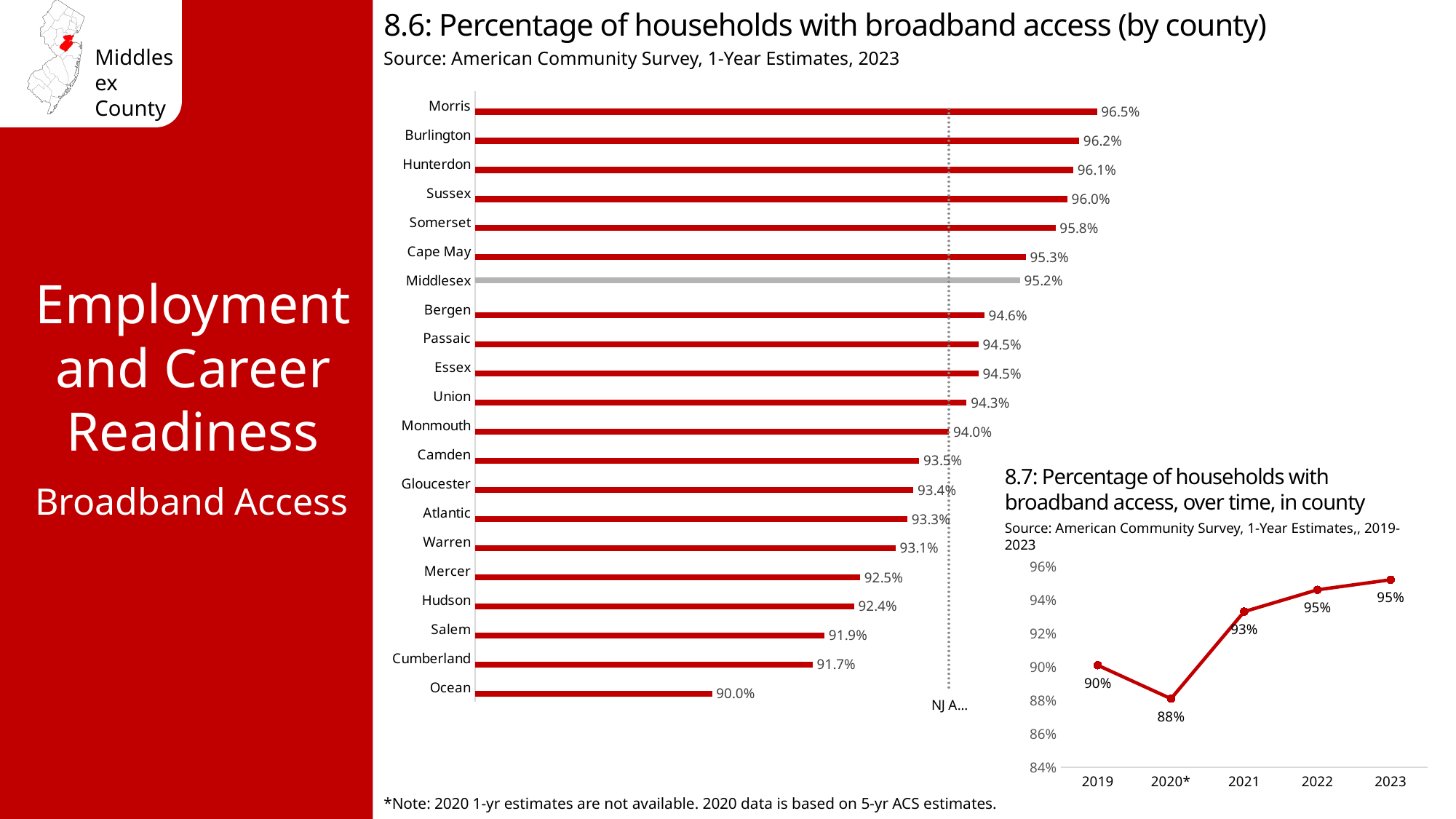
In chart 8.6 (broadband access by county), how many counties are shown? 21 What kind of chart is chart 8.6 (broadband access by county)? Bar chart In chart 8.6 (broadband access by county), which county has the highest percentage of households with broadband access? Morris What kind of chart is chart 8.7 (broadband access over time)? Line chart In chart 8.6 (broadband access by county), what is the value for Middlesex? 95.2% In chart 8.6 (broadband access by county), which is larger, the value for Bergen or the value for Hudson? Bergen In chart 8.7 (broadband access over time), how many data points are plotted? 5 In chart 8.7 (broadband access over time), what is the value for 2020*? 88% In chart 8.7 (broadband access over time), which year has the lowest value? 2020* In chart 8.6 (broadband access by county), which county has the lowest percentage of households with broadband access? Ocean In chart 8.6 (broadband access by county), what is the difference between Morris and Ocean? 6.5% In chart 8.6 (broadband access by county), what is the value for Cumberland? 91.7%